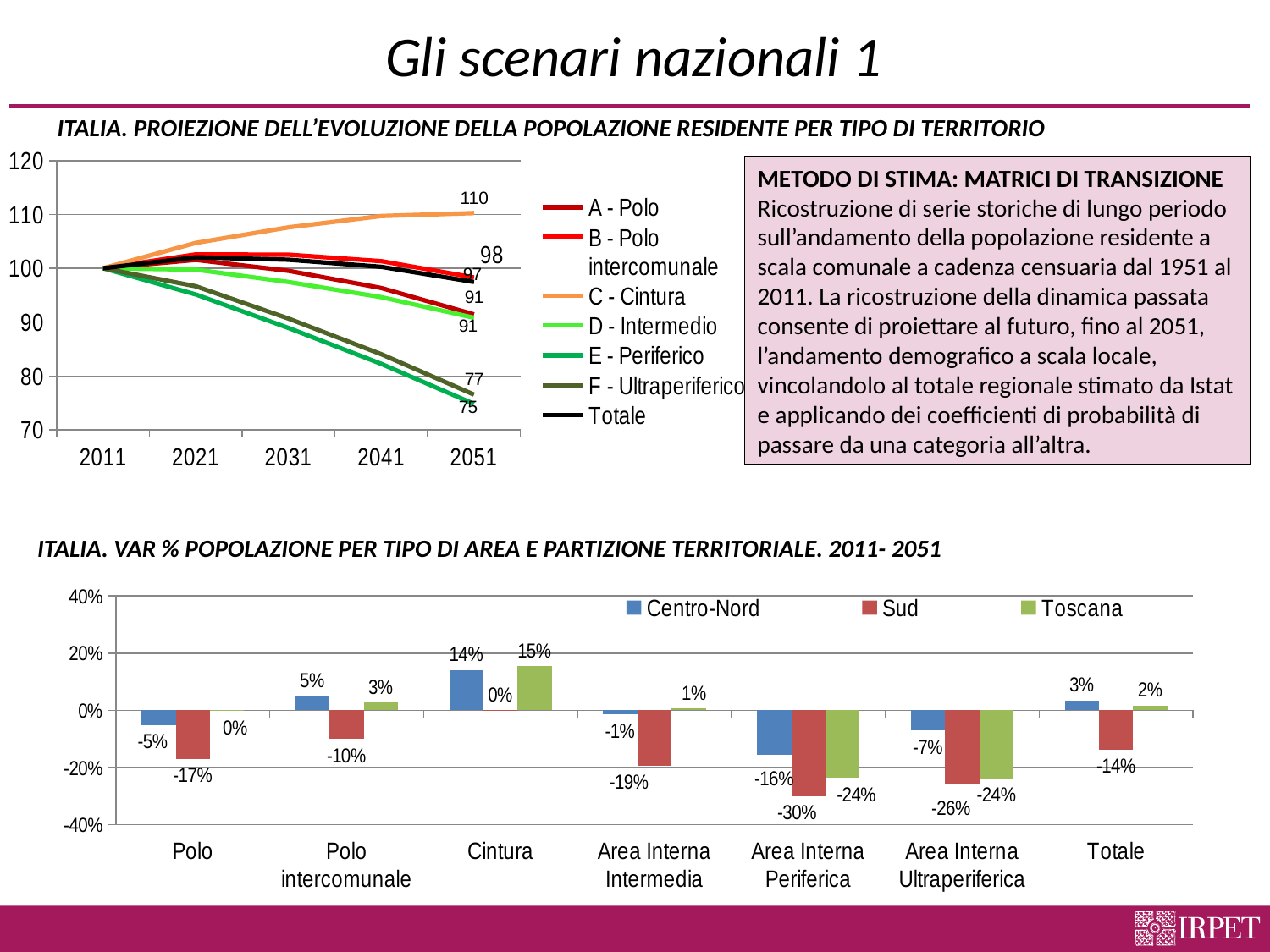
In the bottom chart (ITALIA. VAR % POPOLAZIONE PER TIPO DI AREA E PARTIZIONE TERRITORIALE), what is the value for Sud in the Area Interna Periferica category? -30% In the bottom chart (VAR % POPOLAZIONE), what is the difference between the Centro-Nord and Sud values for Polo intercomunale? 15 percentage points In the top chart (PROIEZIONE DELL'EVOLUZIONE DELLA POPOLAZIONE RESIDENTE), what is the value of C - Cintura in 2051? 110 In the bottom chart (VAR % POPOLAZIONE), what is the value for Toscana in the Cintura category? 15% In the bottom chart (VAR % POPOLAZIONE), what is the value for Centro-Nord in the Totale category? 3% What kind of chart is the top chart (PROIEZIONE DELL'EVOLUZIONE DELLA POPOLAZIONE RESIDENTE)? Line chart How many series does the legend of the bottom chart (VAR % POPOLAZIONE) list? 3 In the bottom chart (VAR % POPOLAZIONE), which category has the highest value for Centro-Nord? Cintura In the bottom chart (VAR % POPOLAZIONE), which category has the lowest value for Sud? Area Interna Periferica In the top chart (PROIEZIONE DELL'EVOLUZIONE DELLA POPOLAZIONE RESIDENTE), does the E - Periferico series rise or fall from 2011 to 2051? Fall How many categories are shown on the x axis of the bottom chart (VAR % POPOLAZIONE)? 7 In the bottom chart (VAR % POPOLAZIONE), which is larger for Area Interna Ultraperiferica: the Centro-Nord value or the Toscana value? Centro-Nord